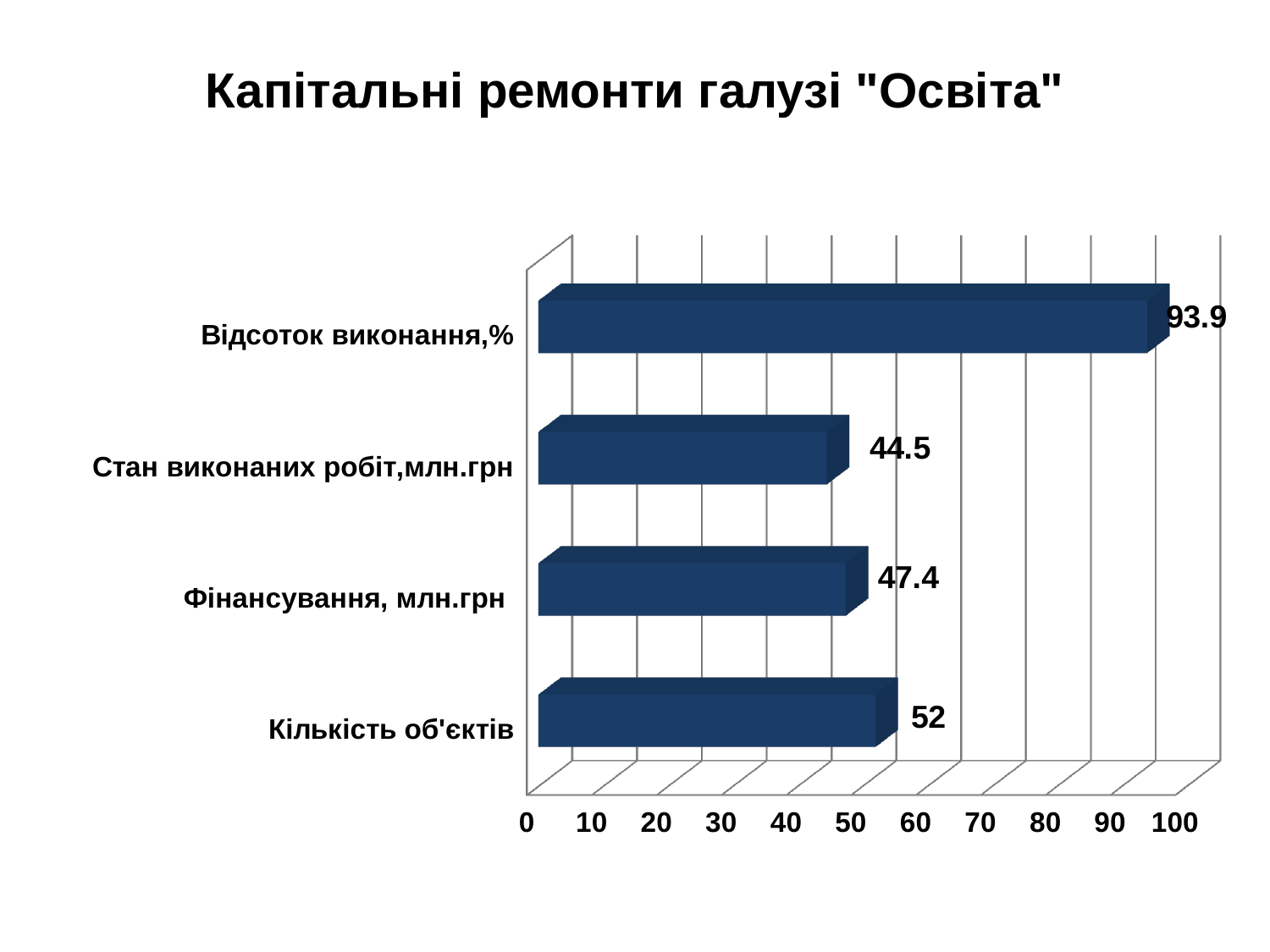
What is the value for Відсоток виконання,%? 93.9 What kind of chart is shown on the slide? bar chart What is the title of the chart? Капітальні ремонти галузі "Освіта" Which category has the lowest value? Стан виконаних робіт,млн.грн How many categories are shown in the chart? 4 Which is larger: Кількість об'єктів or Фінансування, млн.грн? Кількість об'єктів What is the value for Кількість об'єктів? 52 Which category has the highest value? Відсоток виконання,% What is the value for Фінансування, млн.грн? 47.4 What is the difference between Фінансування, млн.грн and Стан виконаних робіт,млн.грн? 2.9 Is the value for Відсоток виконання,% greater or less than 90? greater What is the value for Стан виконаних робіт,млн.грн? 44.5